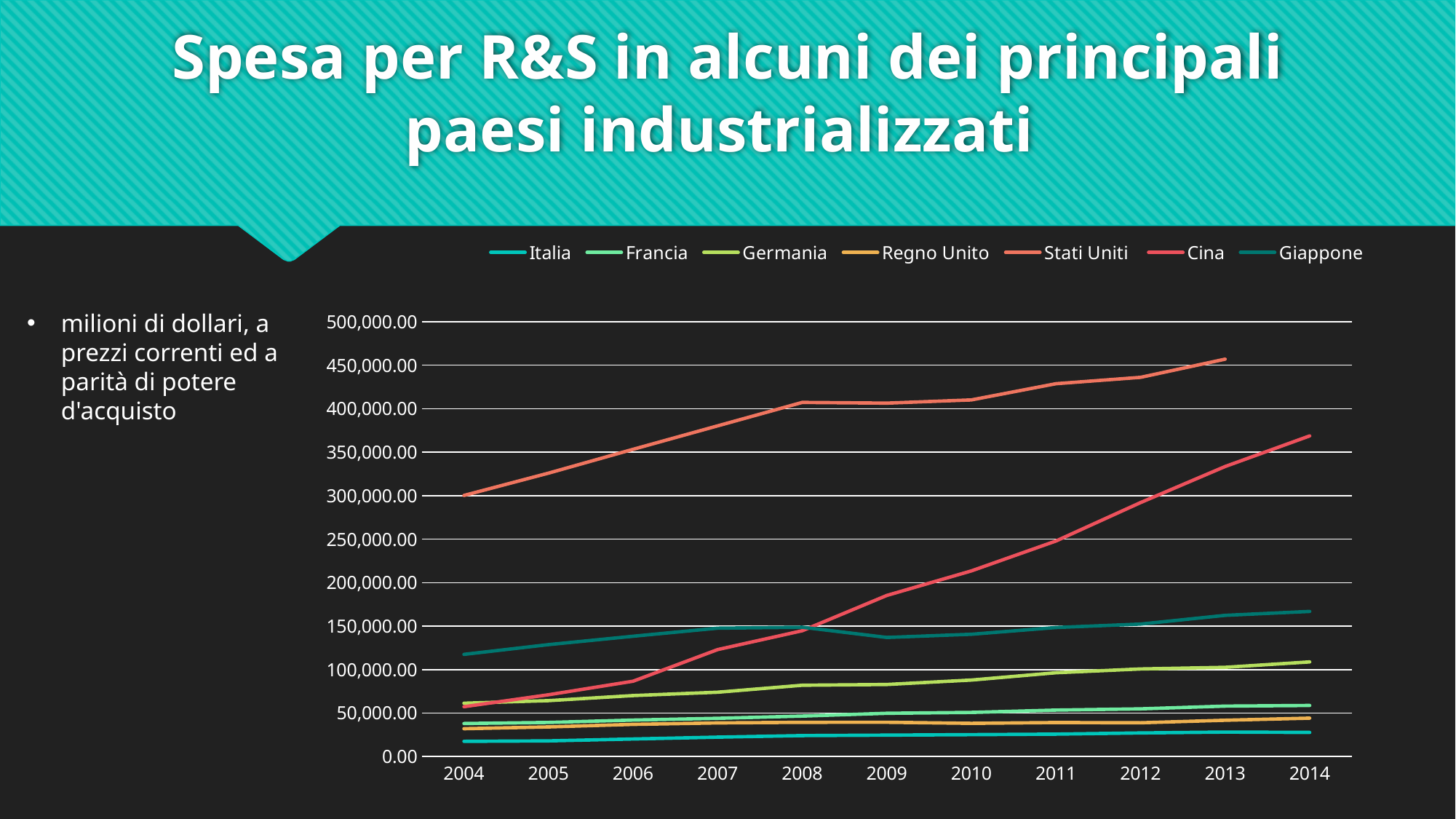
Is the value for Stati Uniti in 2011 greater or less than 400,000.00? greater Is the value for Cina in 2014 greater or less than 350,000.00? greater Which country has the lowest R&D spending line across the chart? Italia What kind of chart is shown on the slide? line chart Which country has the highest R&D spending line across the chart? Stati Uniti How many years are shown on the x axis? 11 How many series does the legend list? 7 Does the value for Cina rise or fall from 2004 to 2014? rise What is the first year shown on the x axis? 2004 Is the value for Italia in 2014 greater or less than 50,000.00? less In 2004, which is larger, the value for Giappone or the value for Cina? Giappone In 2014, which is larger, the value for Cina or the value for Giappone? Cina